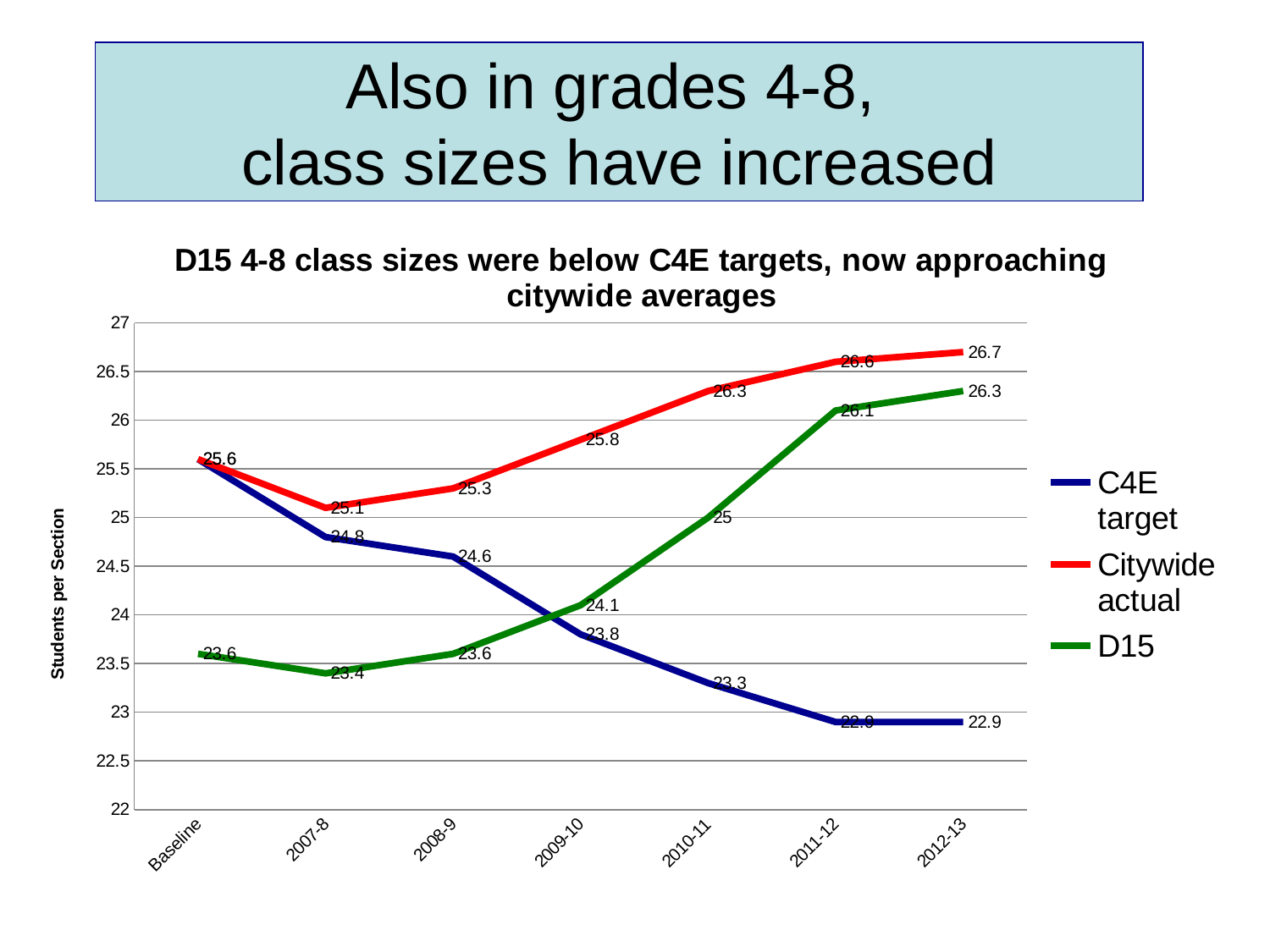
What kind of chart is shown on the slide? Line chart Does the C4E target series rise or fall from Baseline to 2012-13? Fall How many series does the legend list? 3 What is the difference between the Citywide actual and D15 values in 2012-13? 0.4 In which year is the Citywide actual value lowest? 2007-8 What is the C4E target value for 2009-10? 23.8 How many points are plotted along the x axis for each series? 7 In which year does the D15 series reach its highest value? 2012-13 By how much did the D15 value increase from 2010-11 to 2011-12? 1.1 What is the D15 value for 2010-11? 25 What is the Citywide actual value for 2012-13? 26.7 In 2008-9, which is larger: the C4E target or the D15 value? C4E target